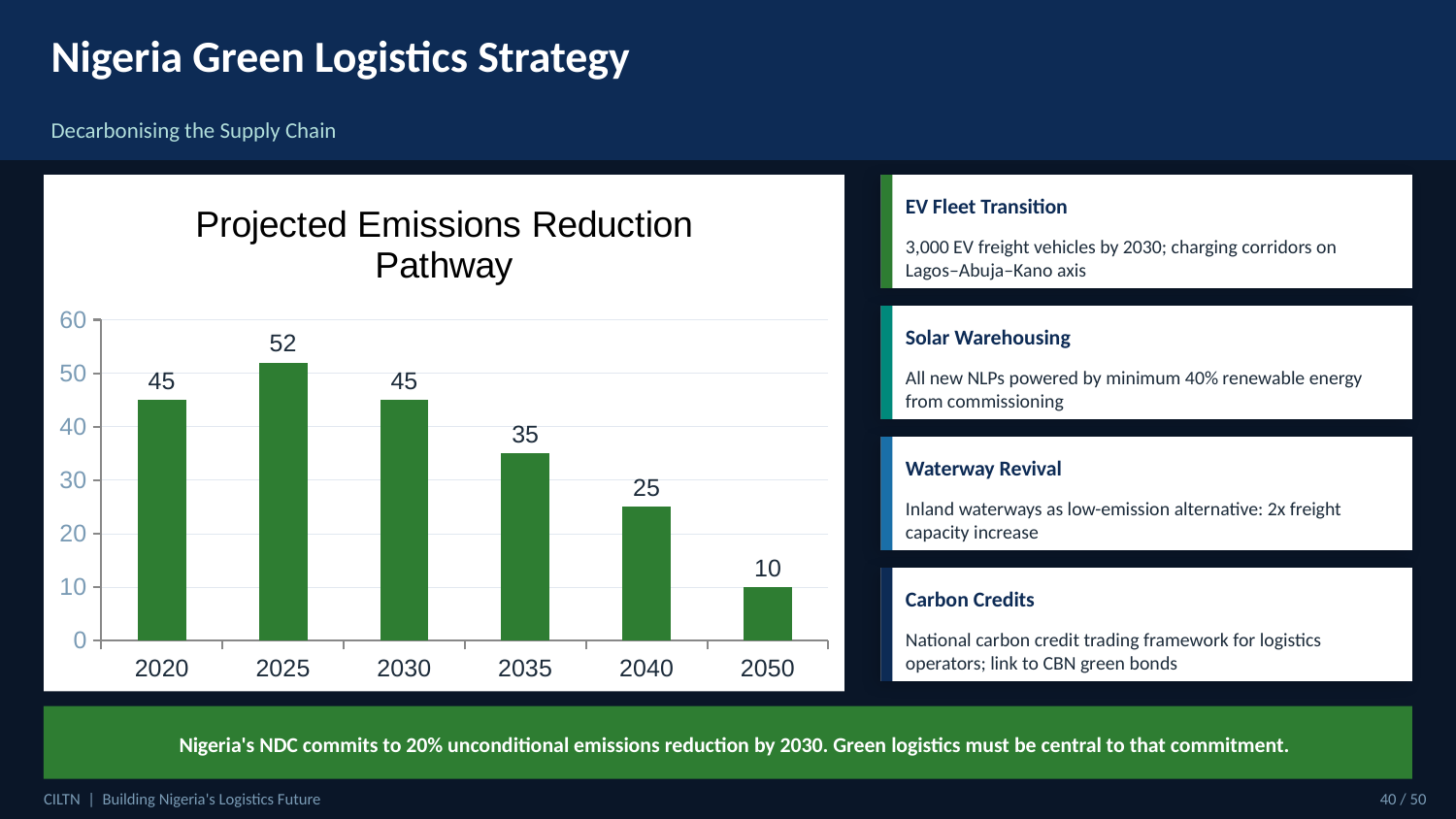
What kind of chart is the Projected Emissions Reduction Pathway chart? bar chart Is the value for 2035 in the Projected Emissions Reduction Pathway chart greater or less than 30? greater What is the difference between the values for 2025 and 2035 in the Projected Emissions Reduction Pathway chart? 17 What is the value for 2040 in the Projected Emissions Reduction Pathway chart? 25 What is the value for 2050 in the Projected Emissions Reduction Pathway chart? 10 How many years are shown on the x axis of the Projected Emissions Reduction Pathway chart? 6 Which year has the highest value in the Projected Emissions Reduction Pathway chart? 2025 What is the title of the chart on the slide? Projected Emissions Reduction Pathway What is the value for 2025 in the Projected Emissions Reduction Pathway chart? 52 Which year has the lowest value in the Projected Emissions Reduction Pathway chart? 2050 Do the values in the Projected Emissions Reduction Pathway chart rise or fall from 2025 to 2050? fall Which is larger in the Projected Emissions Reduction Pathway chart, the value for 2030 or the value for 2040? 2030